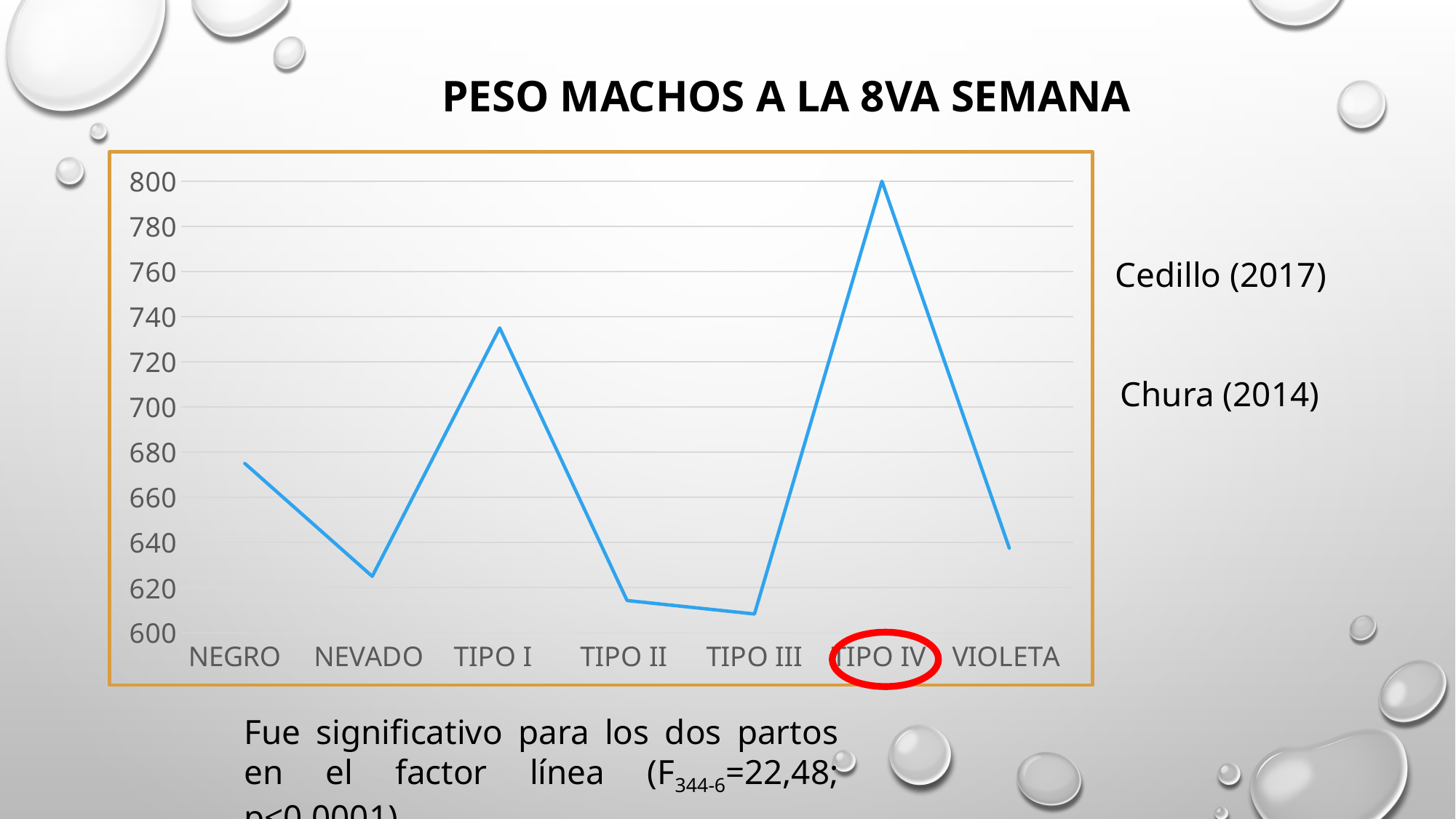
What is the title of the chart? PESO MACHOS A LA 8VA SEMANA Does the line rise or fall from TIPO IV to VIOLETA? fall Is the value for NEVADO greater or less than 640? less Is the value for VIOLETA greater or less than 620? greater Which category has the lowest value? TIPO III Is the value for NEGRO greater or less than 660? greater Which category has the highest value? TIPO IV How many categories are plotted along the x axis? 7 What kind of chart is shown on the slide? line chart Which is larger, the value for TIPO I or the value for NEGRO? TIPO I